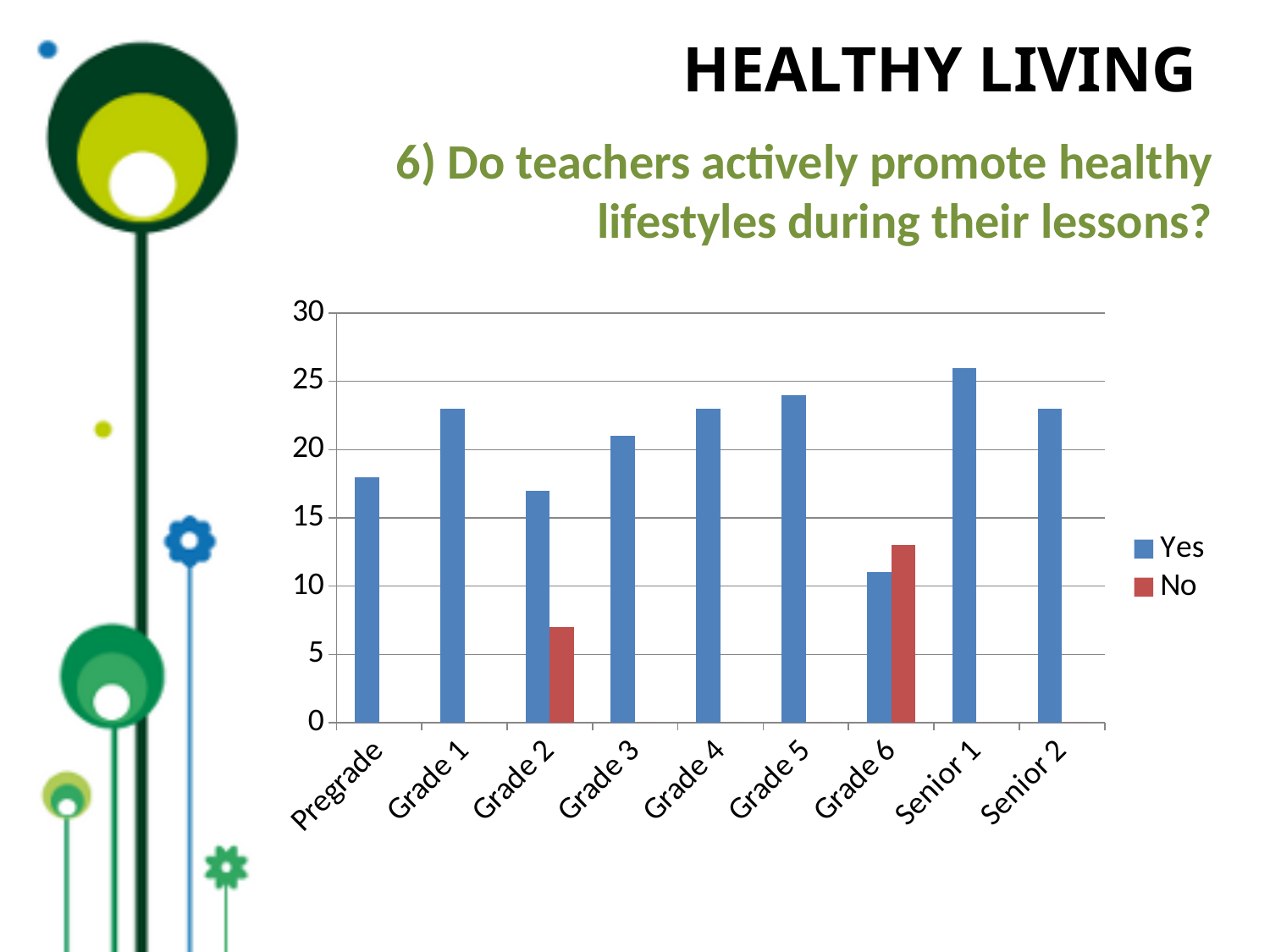
Is the 'Yes' value for Pregrade greater or less than 20? less Which category has the highest 'Yes' bar? Senior 1 Is the 'Yes' value for Grade 6 greater or less than 15? less Which category has the lowest 'Yes' bar? Grade 6 How many series does the legend list? 2 Is the 'No' value for Grade 6 greater or less than 10? greater What kind of chart is shown on the slide? bar chart Which has the larger 'Yes' value, Pregrade or Grade 1? Grade 1 How many grade categories are shown on the x axis? 9 What colour are the 'No' bars in the chart? red For Grade 6, which is larger, the 'Yes' bar or the 'No' bar? No